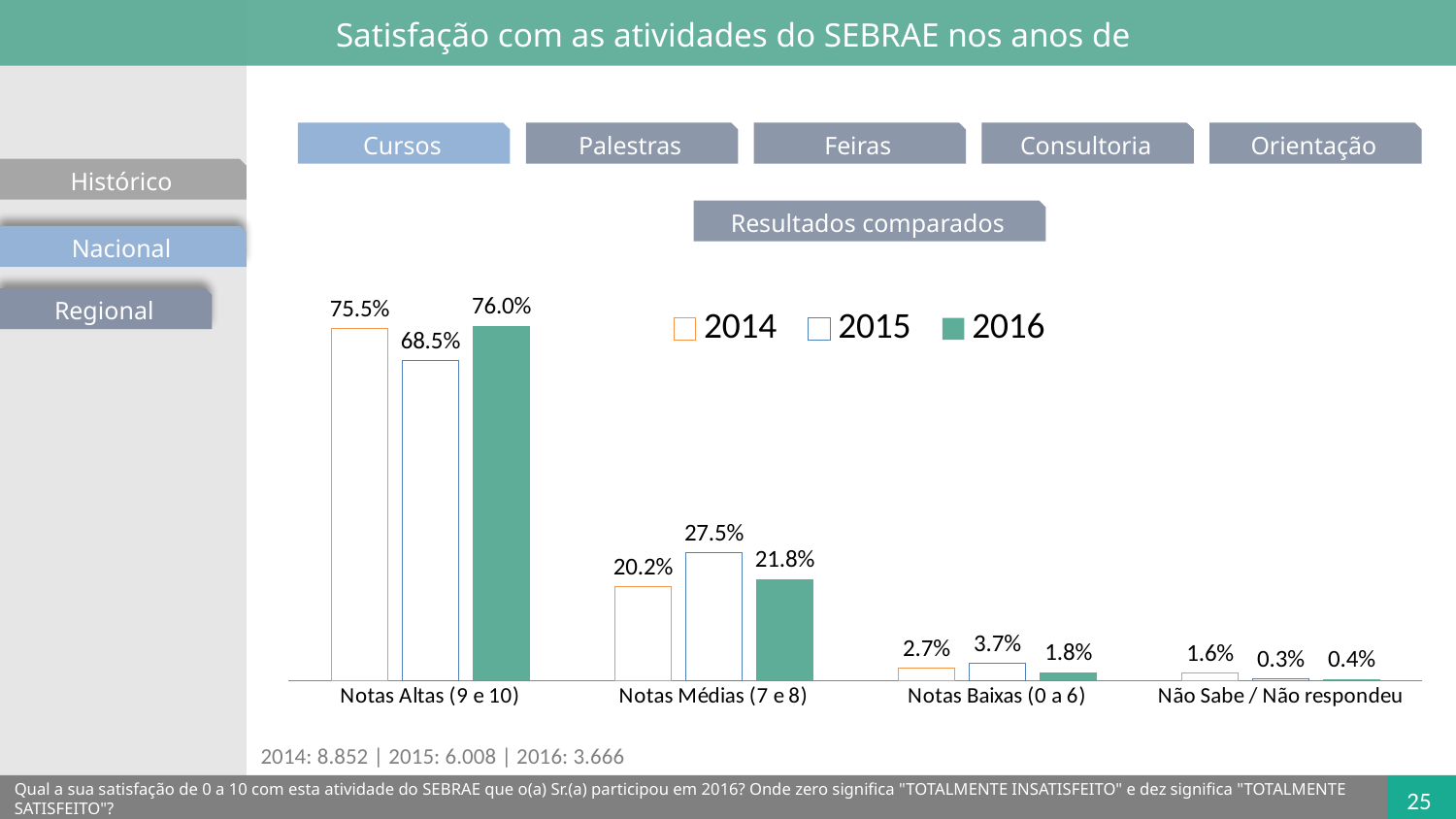
How many series does the legend list? 3 Which series is shown with solid green bars? 2016 What is the difference between the 2015 and 2014 values for Notas Médias (7 e 8)? 7.3% Which is larger for Notas Altas (9 e 10): the 2014 value or the 2015 value? 2014 Which category has the lowest value for 2014? Não Sabe / Não respondeu What is the value for 2015 in the Notas Baixas (0 a 6) category? 3.7% What is the value for 2015 in the Não Sabe / Não respondeu category? 0.3% What kind of chart is shown on the slide? Bar chart What is the value for 2016 in the Notas Altas (9 e 10) category? 76.0% Which category has the highest value for 2015? Notas Altas (9 e 10) How many categories are shown on the x axis? 4 What is the value for 2014 in the Notas Médias (7 e 8) category? 20.2%